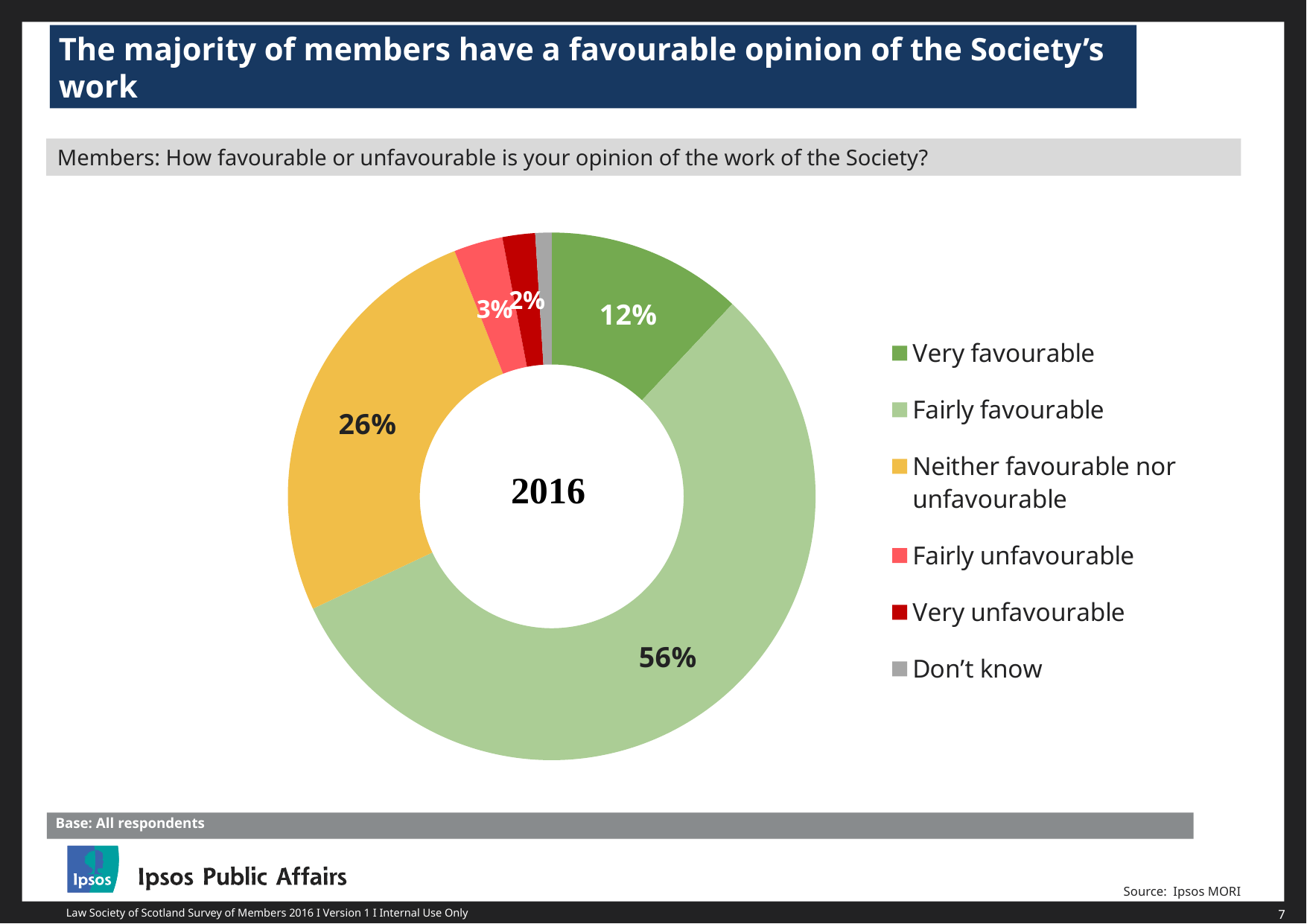
What percentage of members have a very favourable opinion of the work of the Society? 12% What year is shown in the centre of the chart? 2016 What percentage of members have a fairly favourable opinion of the work of the Society? 56% Which response category has the largest share of the pie? Fairly favourable What type of chart is shown on the slide? Pie chart (donut) Which is larger: the share for 'Very favourable' or the share for 'Neither favourable nor unfavourable'? Neither favourable nor unfavourable What percentage of members have a very unfavourable opinion? 2% How many response categories does the legend list? 6 What percentage of members have a fairly unfavourable opinion? 3% What is the difference in percentage points between 'Fairly favourable' and 'Neither favourable nor unfavourable'? 30 What is the combined percentage of members with a very favourable or fairly favourable opinion? 68% What share of members are neither favourable nor unfavourable? 26%